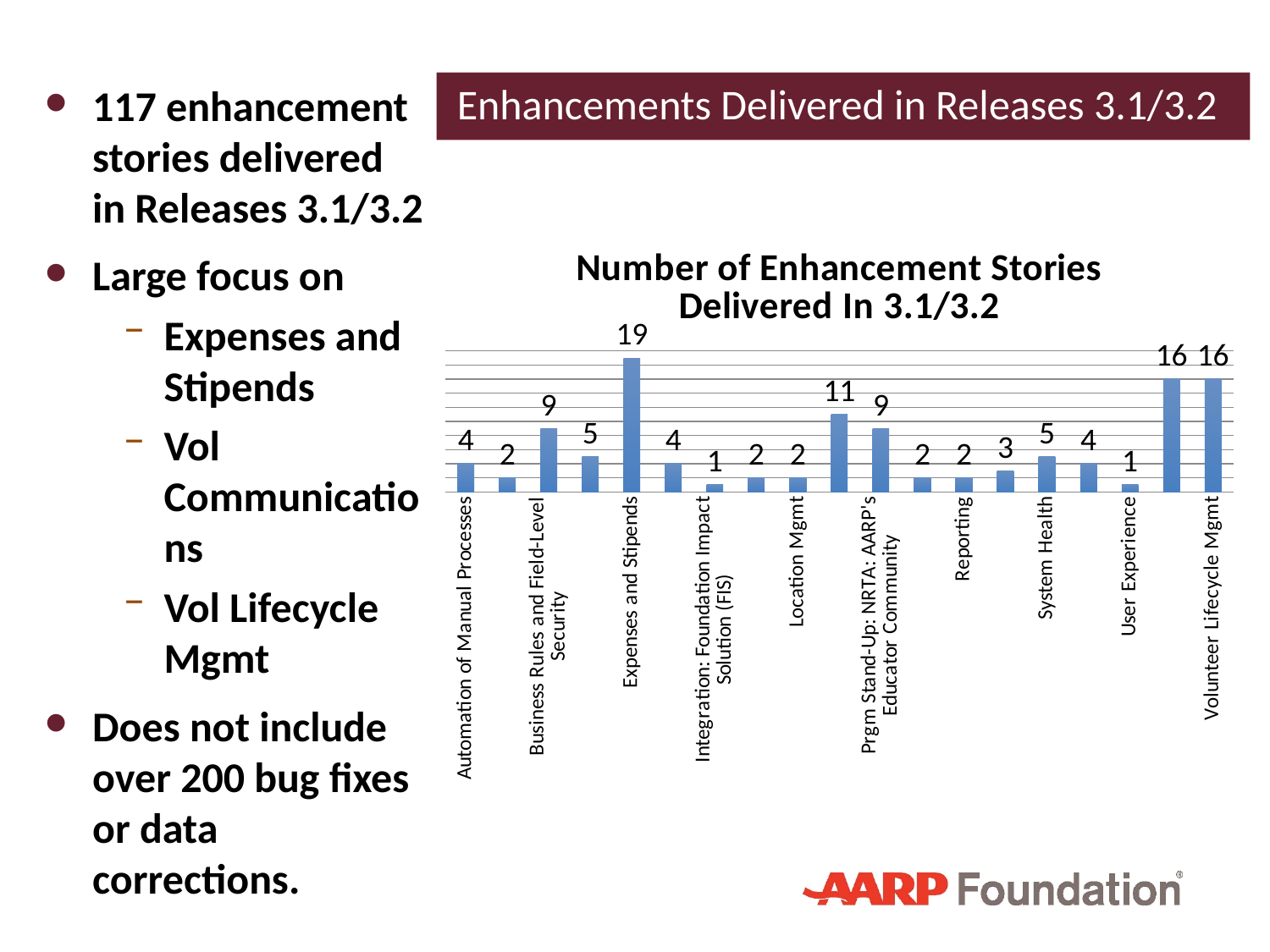
How many enhancement stories were delivered for Automation of Manual Processes? 4 Which category has the highest number of enhancement stories? Expenses and Stipends Which has more enhancement stories, Business Rules and Field-Level Security or System Health? Business Rules and Field-Level Security How many enhancement stories were delivered for Volunteer Lifecycle Mgmt? 16 What type of chart is shown on the slide? bar chart How many enhancement stories were delivered for Expenses and Stipends? 19 How many enhancement stories were delivered for Reporting? 2 What is the chart's title? Number of Enhancement Stories Delivered In 3.1/3.2 How many bars are plotted in the chart? 19 What is the difference between the number of stories for Expenses and Stipends and for Volunteer Lifecycle Mgmt? 3 How many enhancement stories were delivered for Business Rules and Field-Level Security? 9 How many enhancement stories were delivered for System Health? 5